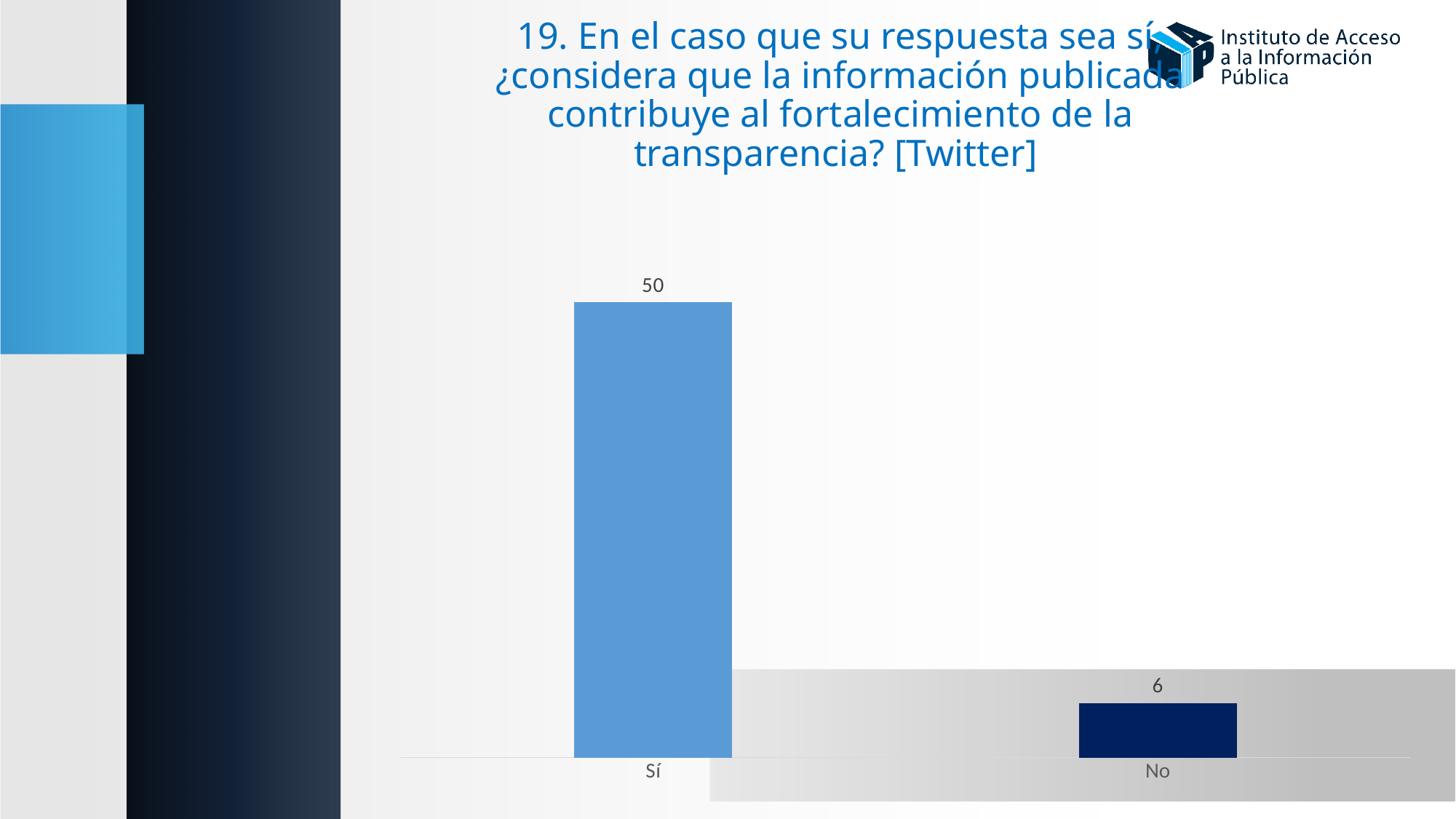
Which social network is named in the chart title? Twitter Which category has the highest value? Sí What is the difference between the values for Sí and No? 44 Which category has the lowest value? No What is the total of the values for Sí and No? 56 What is the value for Sí? 50 What is the value for No? 6 What kind of chart is shown on the slide? Bar chart How many categories are shown in the chart? 2 What colour is the bar for No? Dark navy blue Which is larger, the value for Sí or the value for No? Sí